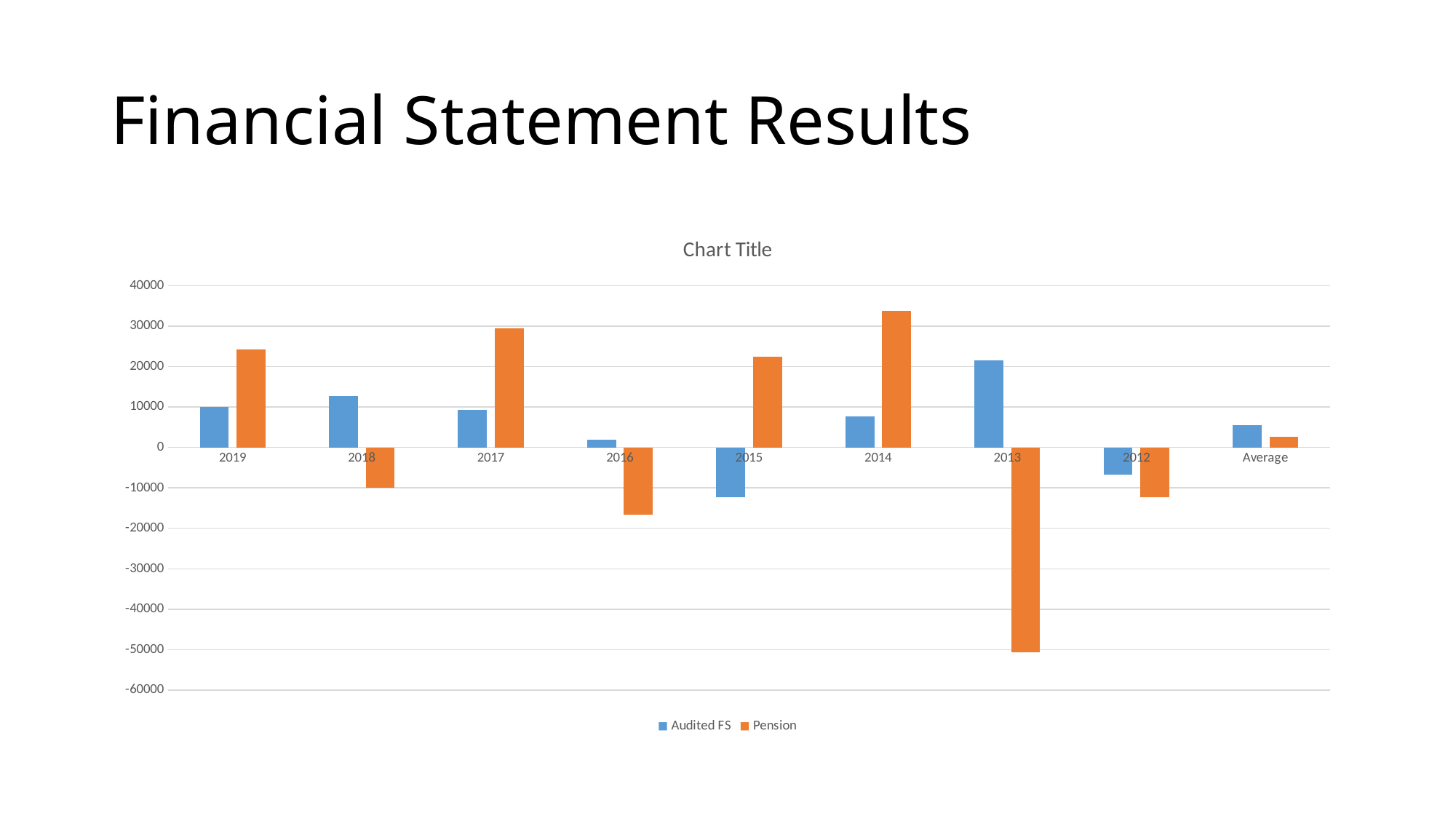
Which category has the lowest Pension value? 2013 What kind of chart is shown on the slide? bar chart Which category has the lowest Audited FS value? 2015 Is the Pension value for 2013 greater or less than -40000? less What are the two series named in the legend? Audited FS and Pension Is the Pension value for 2014 greater or less than 30000? greater How many categories are shown on the x axis? 9 Is the Audited FS value for 2013 greater or less than 20000? greater Which category has the highest Audited FS value? 2013 Which category has the highest Pension value? 2014 For 2019, which series has the larger value, Audited FS or Pension? Pension How many series does the legend list? 2